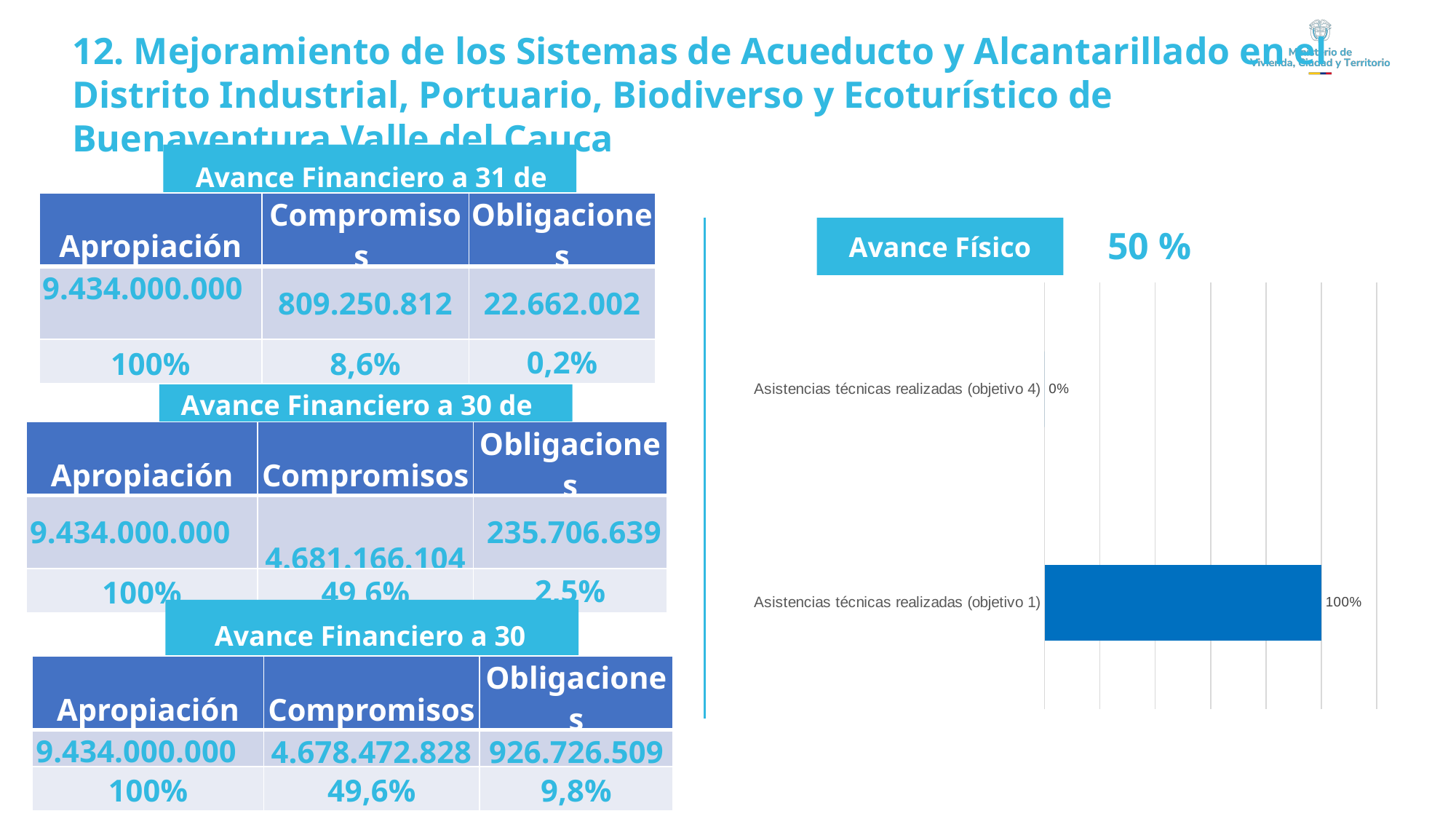
Which is larger in the bar chart: the value for objetivo 1 or the value for objetivo 4? Asistencias técnicas realizadas (objetivo 1) What type of chart is shown on the right side of the slide? bar chart Which category has the highest value in the bar chart? Asistencias técnicas realizadas (objetivo 1) What percentage is displayed next to the 'Avance Físico' heading above the bar chart? 50 % What is the difference between the values for objetivo 1 and objetivo 4 in the bar chart? 100% What is the value for 'Asistencias técnicas realizadas (objetivo 1)' in the bar chart? 100% How many categories are plotted in the bar chart? 2 What is the value for 'Asistencias técnicas realizadas (objetivo 4)' in the bar chart? 0% What is the heading shown above the bar chart? Avance Físico Which category has the lowest value in the bar chart? Asistencias técnicas realizadas (objetivo 4)